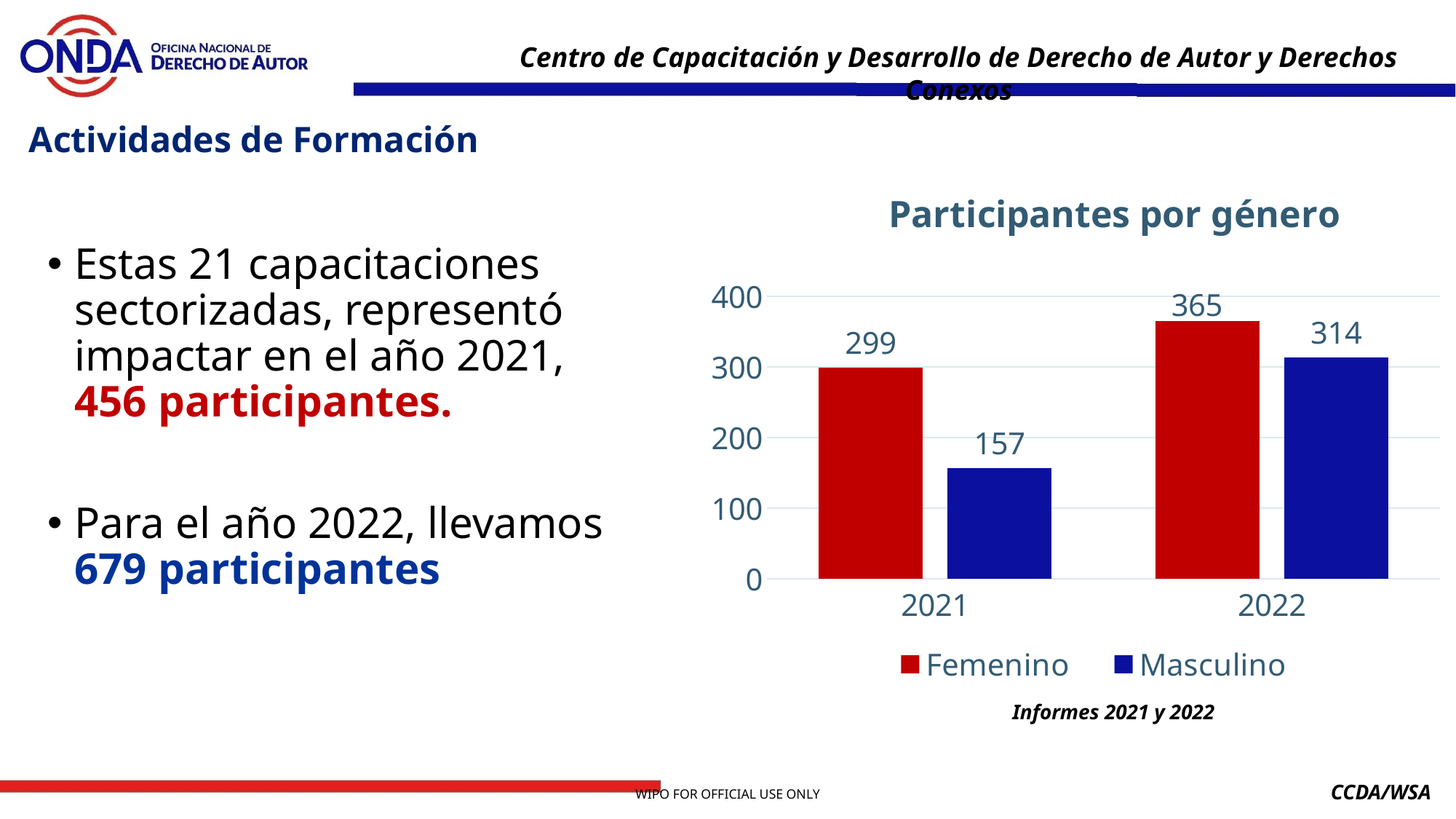
What is the difference between Femenino in 2022 and Femenino in 2021? 66 What is the title of the chart? Participantes por género What kind of chart is shown? Bar chart What is the value for Femenino in 2022? 365 What is the value for Femenino in 2021? 299 Which bar has the lowest value in the chart? Masculino in 2021 Which is larger: Masculino in 2022 or Femenino in 2021? Masculino in 2022 What is the value for Masculino in 2021? 157 What is the value for Masculino in 2022? 314 Which series has the highest value in 2022? Femenino How many series does the legend list? 2 What is the difference between Femenino and Masculino in 2021? 142